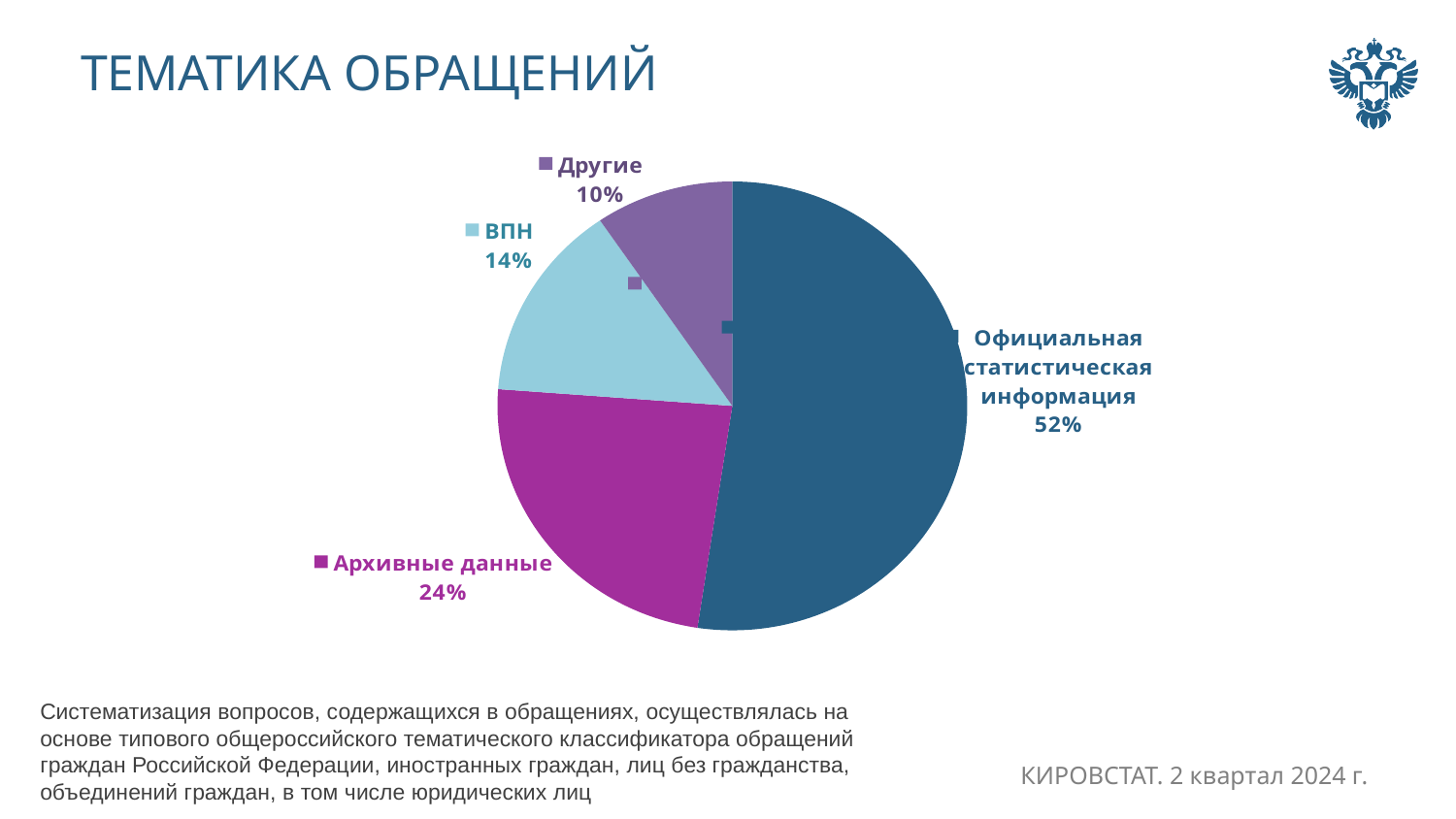
Which category has the largest share of the pie? Официальная статистическая информация What is the difference between the shares of "Официальная статистическая информация" and "Архивные данные"? 28% What is the value shown for "Другие"? 10% What share of the pie does "Официальная статистическая информация" have? 52% What is the title of the chart on the slide? ТЕМАТИКА ОБРАЩЕНИЙ How many categories are shown in the pie chart? 4 What is the value shown for "Архивные данные"? 24% What is the difference between the shares of "Архивные данные" and "ВПН"? 10% Which category has the smallest share of the pie? Другие What is the value shown for "ВПН"? 14% Which is larger, the share for "ВПН" or the share for "Другие"? ВПН What type of chart is shown on the slide? pie chart